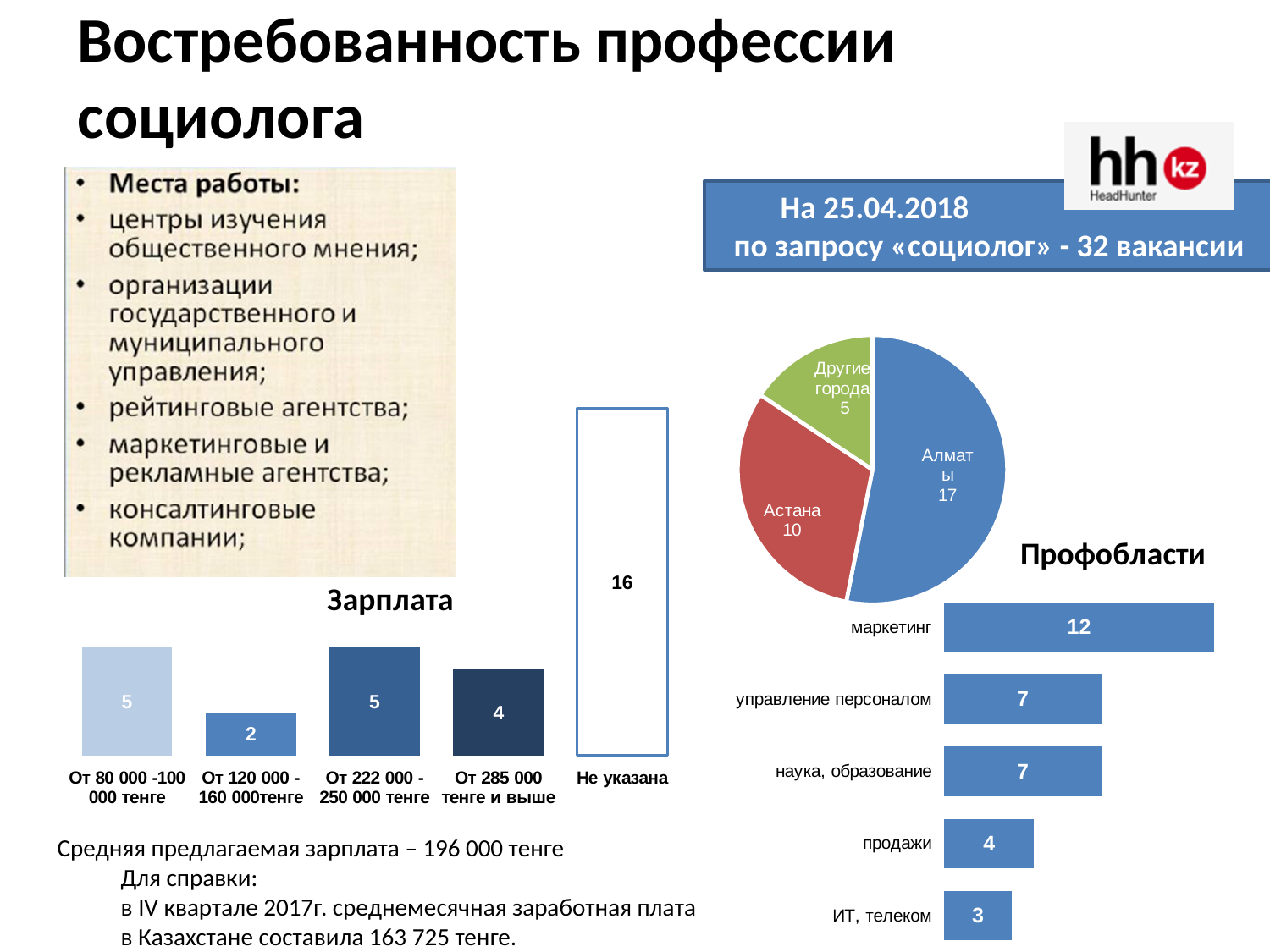
In the pie chart, which slice is the largest? Алматы In the "Зарплата" chart, what is the value for "От 120 000 - 160 000тенге"? 2 In the "Профобласти" chart, which category has the lowest value? ИТ, телеком In the "Профобласти" chart, what is the value for "маркетинг"? 12 In the "Зарплата" chart, which category has the highest value? Не указана In the pie chart, what is the total of all slices? 32 What kind of chart is the "Профобласти" chart? bar chart In the "Зарплата" chart, how many categories are shown? 5 In the "Зарплата" chart, what is the difference between "Не указана" and "От 285 000 тенге и выше"? 12 In the "Зарплата" chart, what is the value for "Не указана"? 16 In the "Зарплата" chart, which category has the lowest value? От 120 000 - 160 000тенге In the pie chart, what is the value for "Астана"? 10